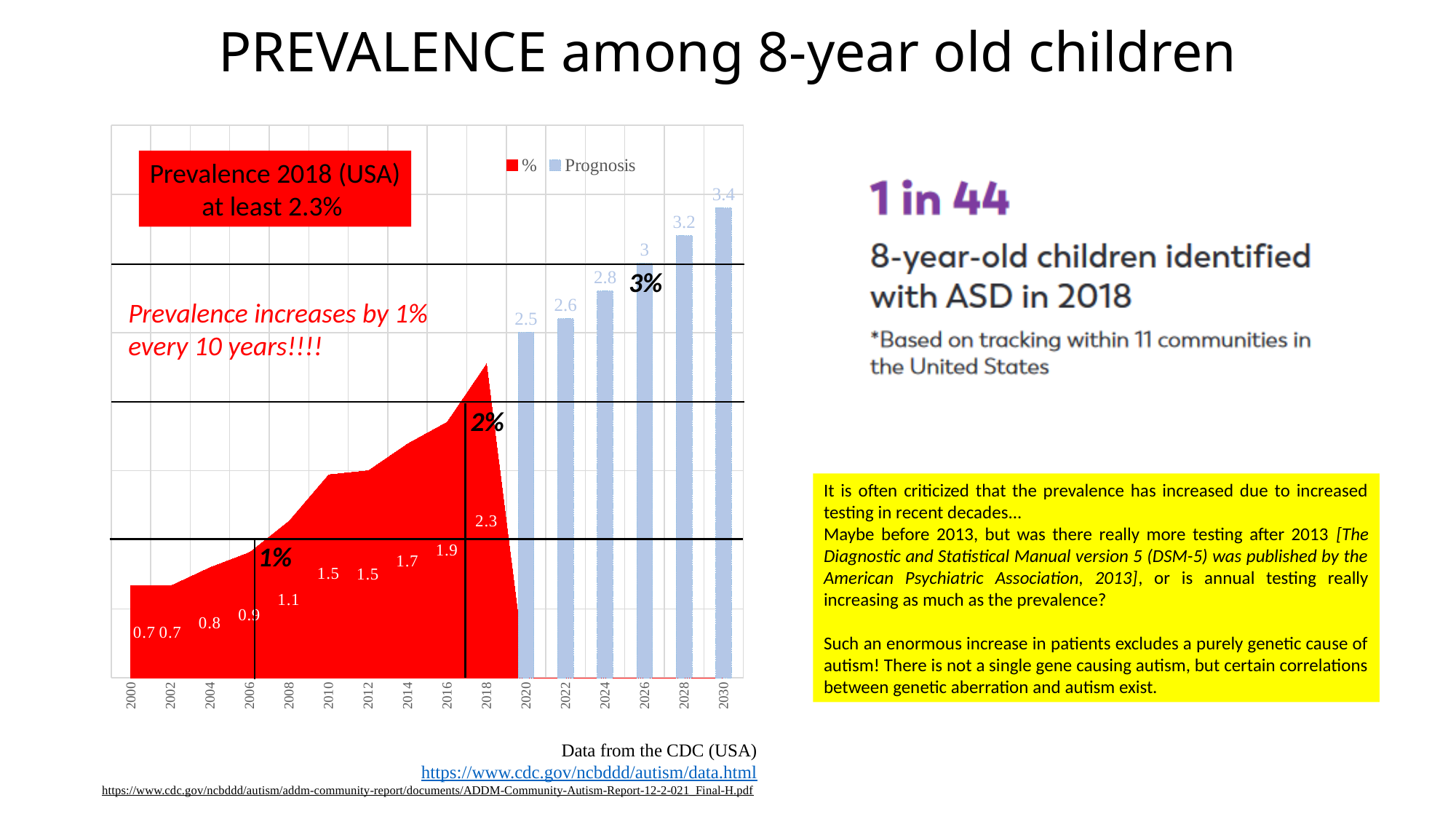
What are the two series named in the legend? % and Prognosis What is the value of the % series for 2008? 1.1 How many series does the legend list? 2 How many years are shown on the x axis? 16 Do the values rise or fall from 2000 to 2030? rise What is the Prognosis value for 2026? 3 Which year has the lowest value in the % series? 2000 and 2002 (both 0.7) Which year has the highest Prognosis value? 2030 Which is larger, the % value for 2010 or the % value for 2016? 2016 What is the Prognosis value for 2030? 3.4 What is the difference between the % value for 2018 and the % value for 2000? 1.6 What is the value of the % series for 2018? 2.3